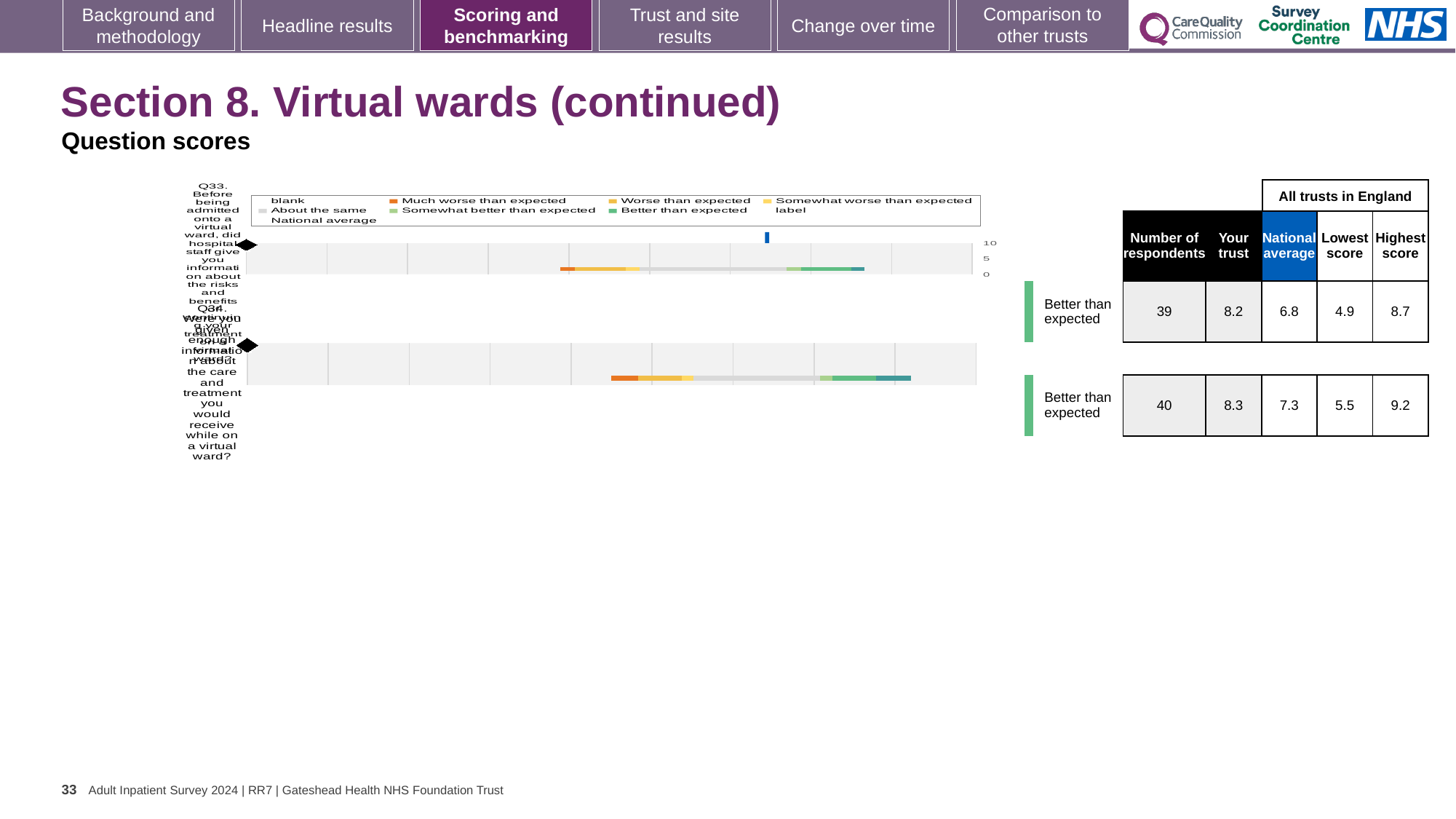
What is the highest score among all trusts in England for Q33? 8.7 How many questions (bars) are plotted in the chart? 2 Which question has the higher 'Your trust' score, Q33 or Q34? Q34 What kind of chart is shown on the slide? Bar chart How many respondents answered Q34? 40 What is the 'Your trust' score for Q33? 8.2 What is the national average score for Q34? 7.3 What benchmark category is shown for both Q33 and Q34? Better than expected What colour does the legend use for 'Much worse than expected'? Orange Which question numbers are plotted in the chart? Q33 and Q34 What is the difference between the 'Your trust' score and the national average for Q33? 1.4 What is the lowest score among all trusts in England for Q34? 5.5